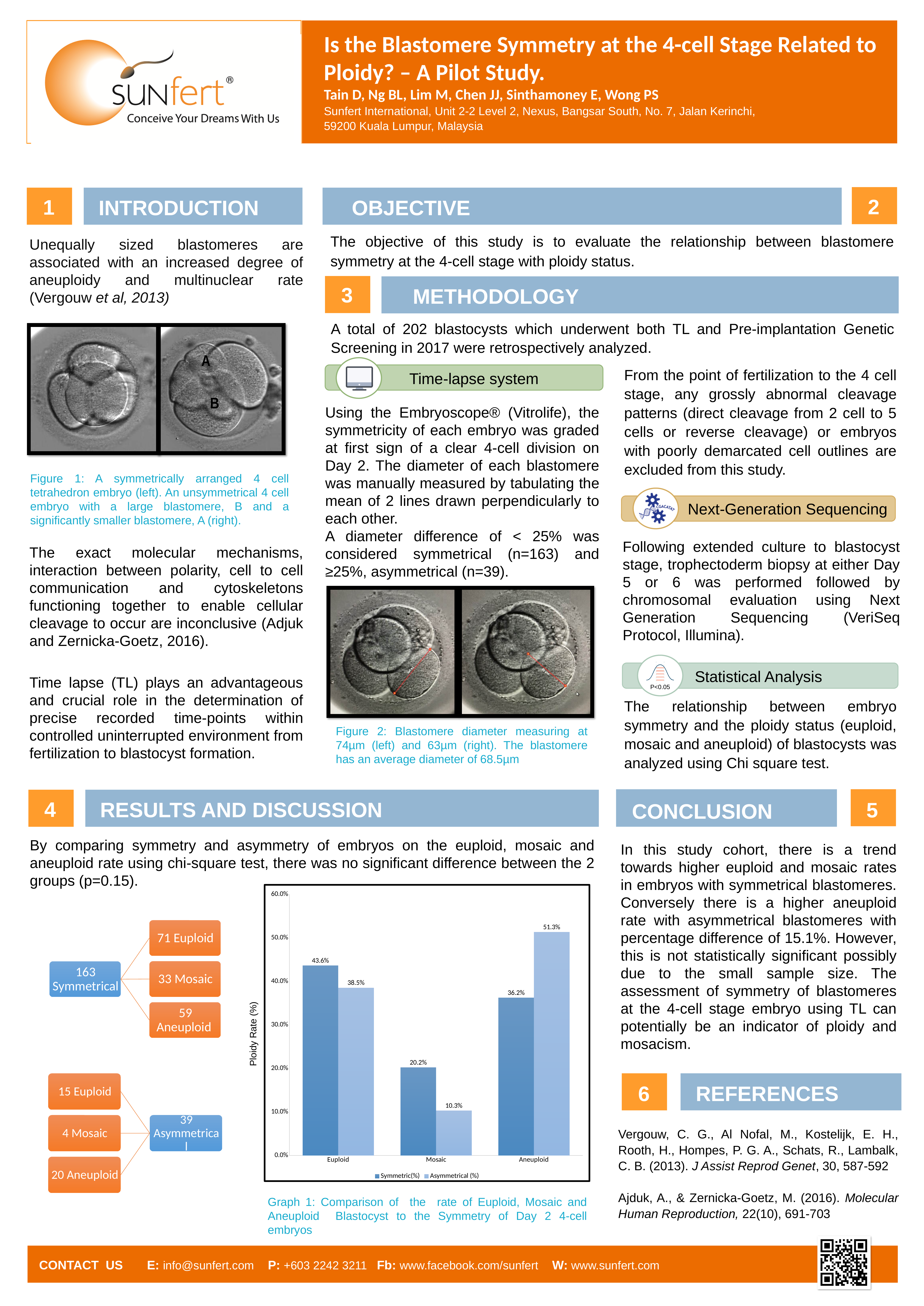
In Graph 1, what is the Symmetric(%) value for Euploid? 43.6% In Graph 1, which category has the highest Asymmetrical (%) value? Aneuploid In Graph 1, what is the Asymmetrical (%) value for Mosaic? 10.3% In Graph 1, which is larger for Euploid: the Symmetric(%) value or the Asymmetrical (%) value? Symmetric(%) In Graph 1, what is the Asymmetrical (%) value for Aneuploid? 51.3% In Graph 1, which category has the lowest Symmetric(%) value? Mosaic How many categories are shown on the x axis of Graph 1? 3 How many series does the legend of Graph 1 list? 2 In Graph 1, what is the difference between the Symmetric(%) and Asymmetrical (%) values for Mosaic? 9.9% In Graph 1, what is the difference between the Asymmetrical (%) and Symmetric(%) values for Aneuploid? 15.1% What is the label of the y axis in Graph 1? Ploidy Rate (%) What kind of chart is Graph 1? bar chart